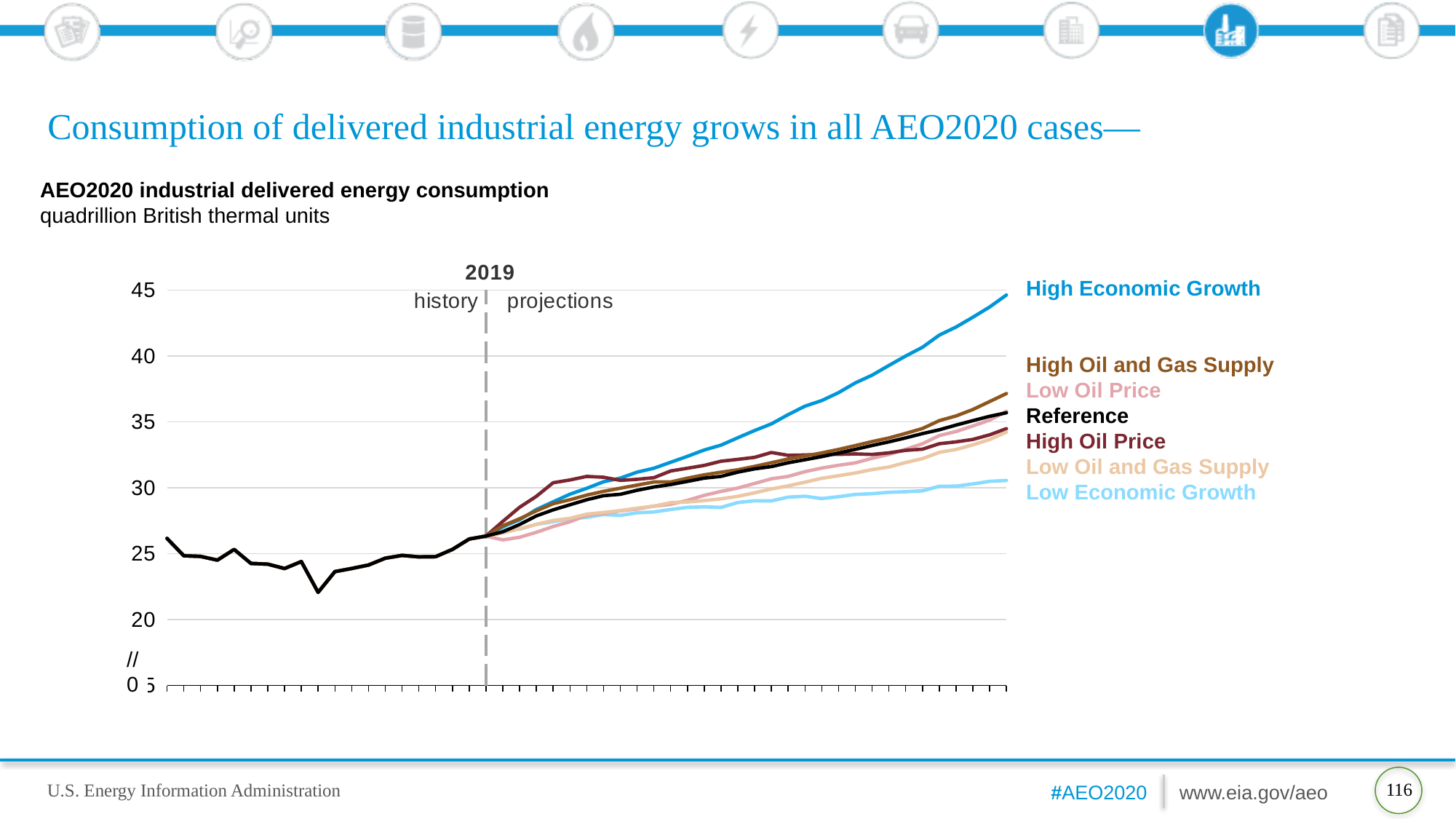
Is the value for the Low Economic Growth case at the end of the projection period greater or less than 35? less What kind of chart is shown on the slide? line chart What unit is the chart's y axis measured in? quadrillion British thermal units Which case has the highest industrial delivered energy consumption at the end of the projection period? High Economic Growth At the end of the projection period, which is larger: the High Economic Growth case or the Low Economic Growth case? High Economic Growth Is the value for the High Oil and Gas Supply case at the end of the projection period greater or less than 40? less Is the value for the High Economic Growth case at the end of the projection period greater or less than 40? greater Do the projected values for the Reference case rise or fall over the projection period? rise What year does the dashed vertical line separating history from projections mark? 2019 Which case has the lowest industrial delivered energy consumption at the end of the projection period? Low Economic Growth How many cases (series) are labelled on the chart? 7